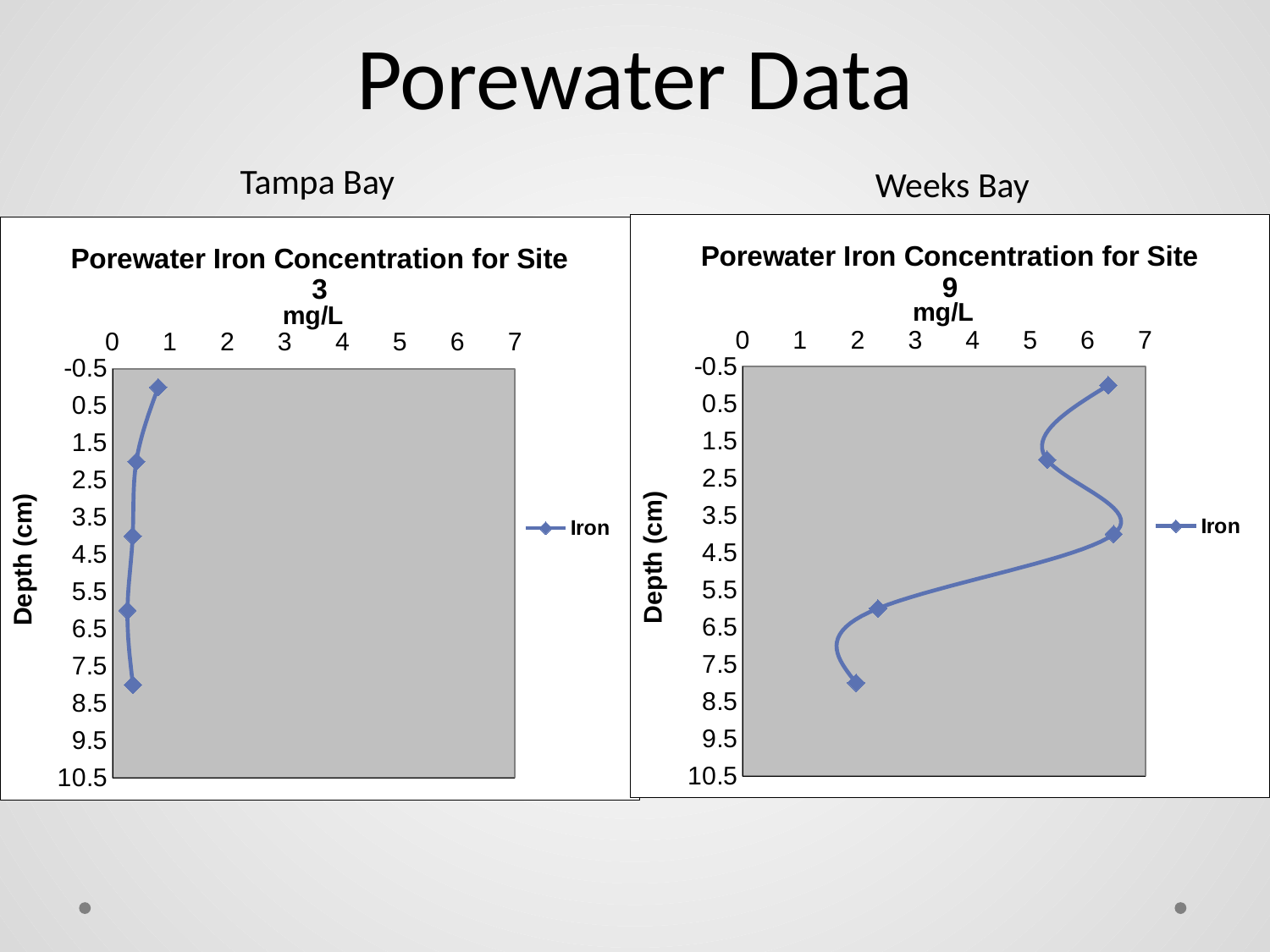
How many data points are plotted on the Tampa Bay chart (Porewater Iron Concentration for Site 3)? 5 On the Weeks Bay chart, is the iron value for the second point from the top greater or less than 5 mg/L? greater On the Weeks Bay chart, is the iron value for the deepest point greater or less than 3 mg/L? less On the Tampa Bay chart, is the iron value for the shallowest point greater or less than 1 mg/L? less On the Tampa Bay chart, which point has the highest iron concentration? the shallowest point How many series does the legend of the Weeks Bay chart list? 1 What is the label on the vertical axis of the Tampa Bay chart? Depth (cm) What kind of chart is the Tampa Bay chart (Porewater Iron Concentration for Site 3)? line chart Which chart shows the higher iron concentration at its shallowest point, Tampa Bay or Weeks Bay? Weeks Bay On the Weeks Bay chart, which is larger: the iron value at the shallowest point or at the deepest point? the shallowest point How many data points are plotted on the Weeks Bay chart (Porewater Iron Concentration for Site 9)? 5